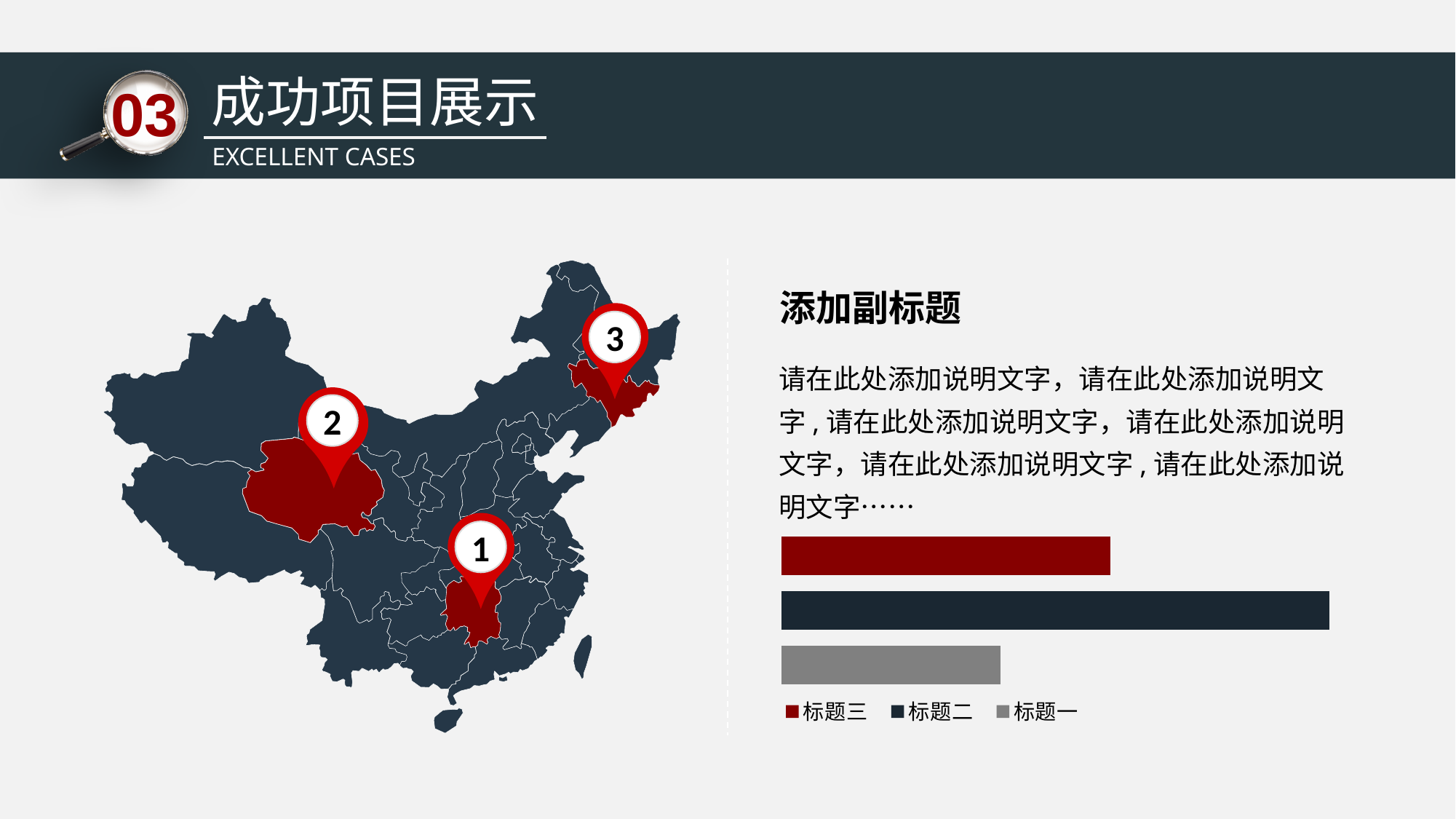
What kind of chart is shown on the right side of the slide? bar chart Which series has the shortest bar in the chart? 标题一 Which bar is shorter, 标题一 or 标题二? 标题一 Which series has the longest bar in the chart? 标题二 Which bar is longer, 标题二 or 标题三? 标题二 What colour is the bar for 标题一 in the chart? gray Which bar is longer, 标题三 or 标题一? 标题三 How many bars are plotted in the chart? 3 What colour is the bar for 标题三 in the chart? dark red How many series does the chart legend list? 3